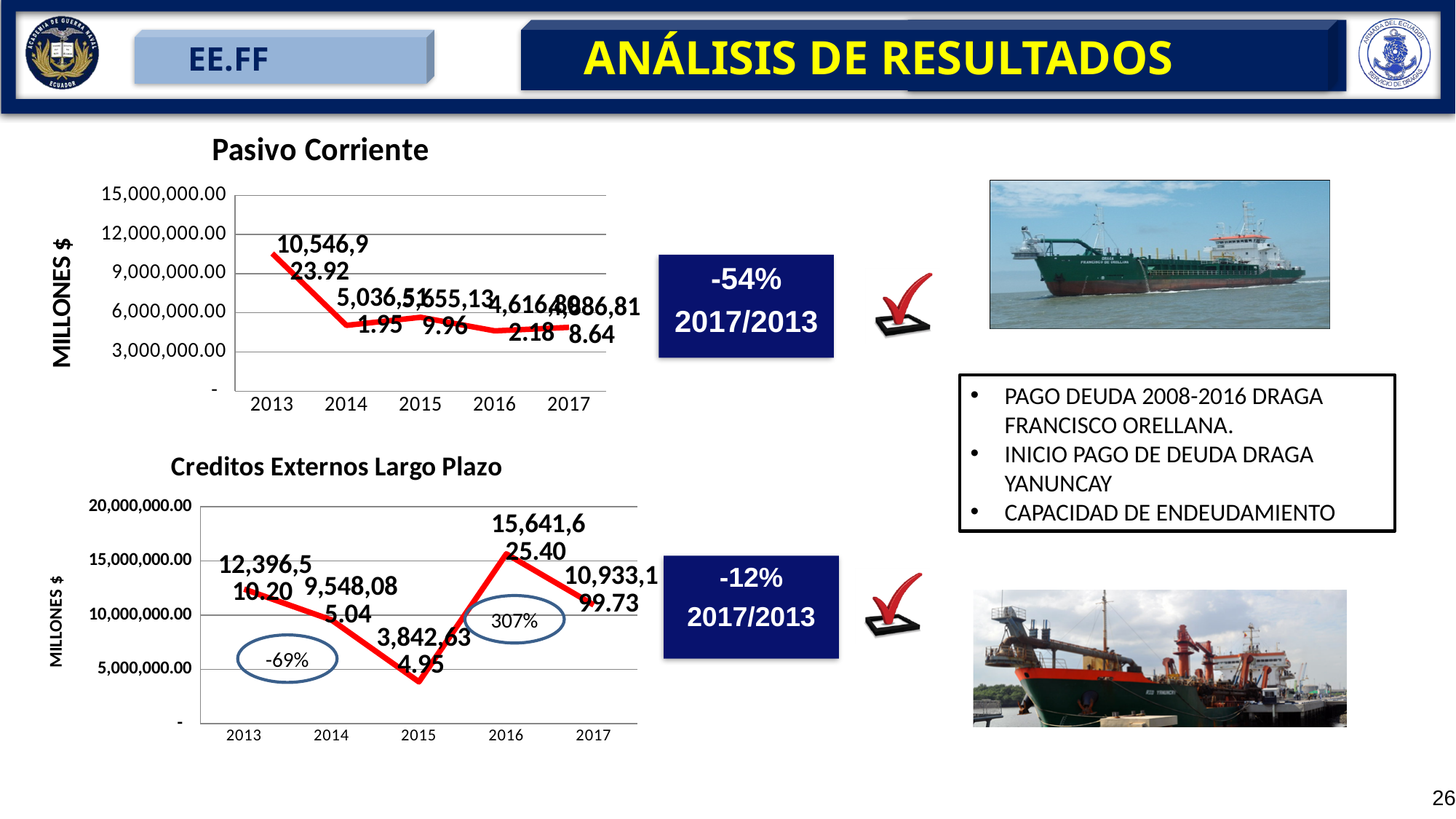
In the 'Creditos Externos Largo Plazo' chart, is the value for 2015 greater or less than 5,000,000.00? less In the 'Pasivo Corriente' chart, which is larger, the value for 2013 or the value for 2017? 2013 In the 'Pasivo Corriente' chart, how many years are plotted on the x axis? 5 What kind of chart is the 'Pasivo Corriente' chart? line chart In the 'Pasivo Corriente' chart, which year has the highest value? 2013 What percentage change for 2017/2013 is shown next to the 'Pasivo Corriente' chart? -54% In the 'Creditos Externos Largo Plazo' chart, what is the value for 2016? 15,641,625.40 In the 'Pasivo Corriente' chart, is the value for 2016 greater or less than 6,000,000.00? less In the 'Pasivo Corriente' chart, is the value for 2013 greater or less than 9,000,000.00? greater In the 'Creditos Externos Largo Plazo' chart, which year has the lowest value? 2015 In the 'Creditos Externos Largo Plazo' chart, which year has the highest value? 2016 In the 'Pasivo Corriente' chart, does the value overall rise or fall from 2013 to 2017? fall